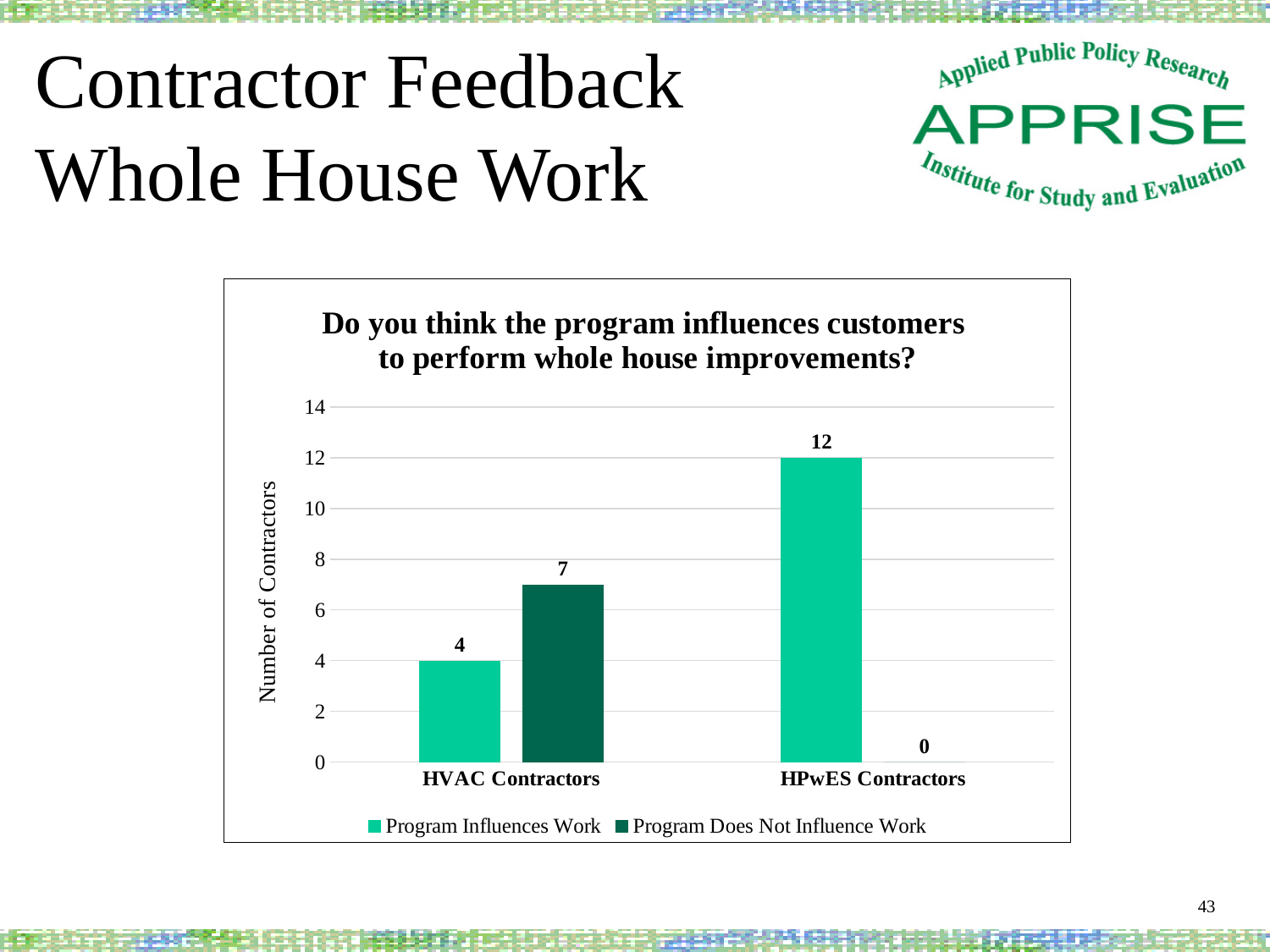
For HVAC Contractors, which is larger: Program Influences Work or Program Does Not Influence Work? Program Does Not Influence Work Which contractor group has the highest value for Program Influences Work? HPwES Contractors Which contractor group has the lowest value for Program Does Not Influence Work? HPwES Contractors How many HVAC Contractors said the program does not influence work? 7 How many HPwES Contractors said the program does not influence work? 0 What kind of chart is shown on the slide? Bar chart What is the difference between the Program Influences Work values for HPwES Contractors and HVAC Contractors? 8 How many HVAC Contractors said the program influences work? 4 How many series does the legend list? 2 What is the label of the vertical axis? Number of Contractors How many contractor categories are shown on the x axis? 2 How many HPwES Contractors said the program influences work? 12